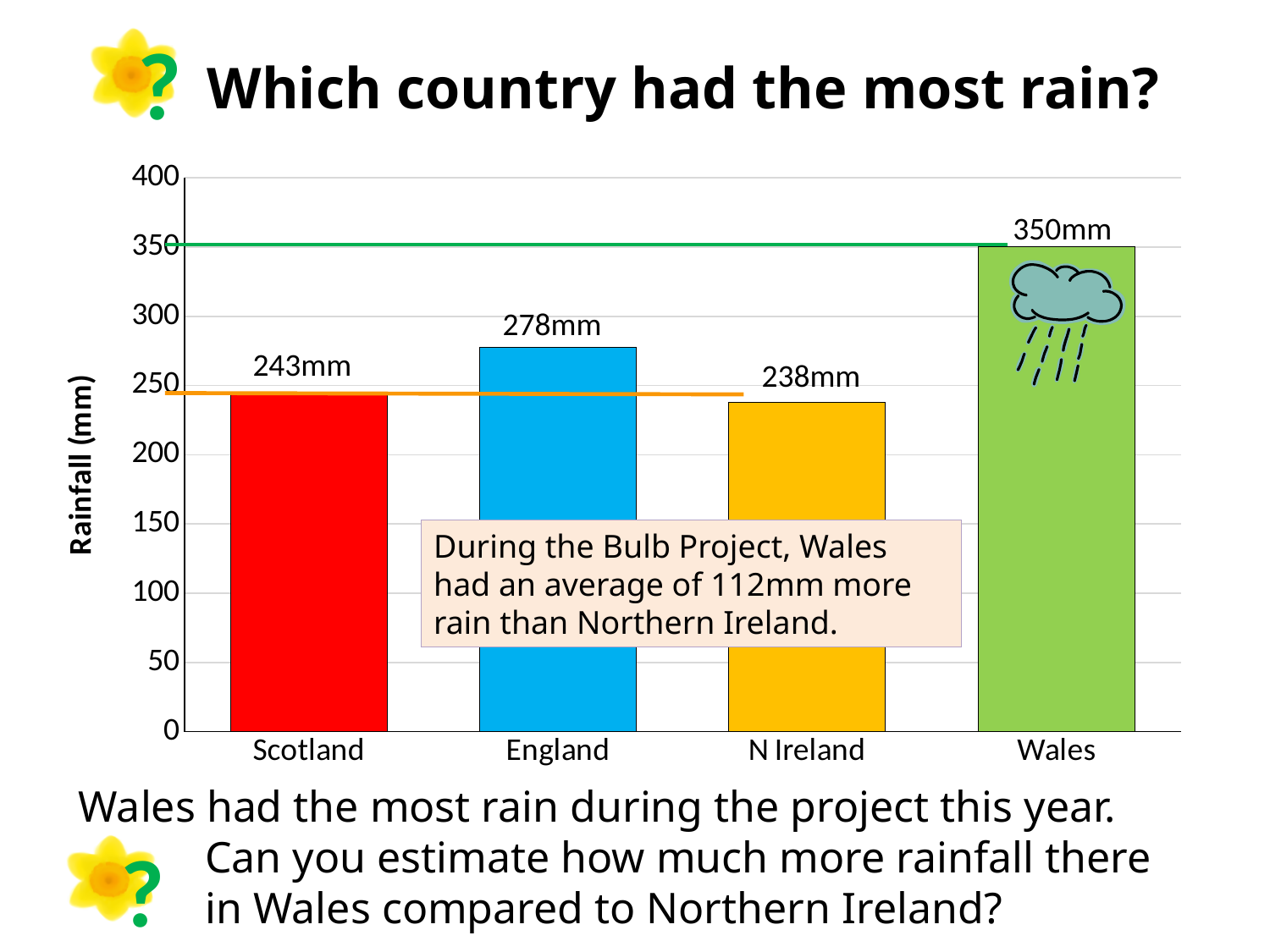
What is the rainfall value for Scotland? 243mm What is the difference in rainfall between Wales and N Ireland? 112mm What is the rainfall value for Wales? 350mm What is the difference in rainfall between England and Scotland? 35mm How many countries are shown on the chart? 4 Is the value for Wales greater or less than 300? greater Which has more rainfall, England or Scotland? England Which country has the lowest rainfall? N Ireland Which country has the highest rainfall? Wales What kind of chart is shown on the slide? Bar chart What is the rainfall value for England? 278mm What is the rainfall value for N Ireland? 238mm